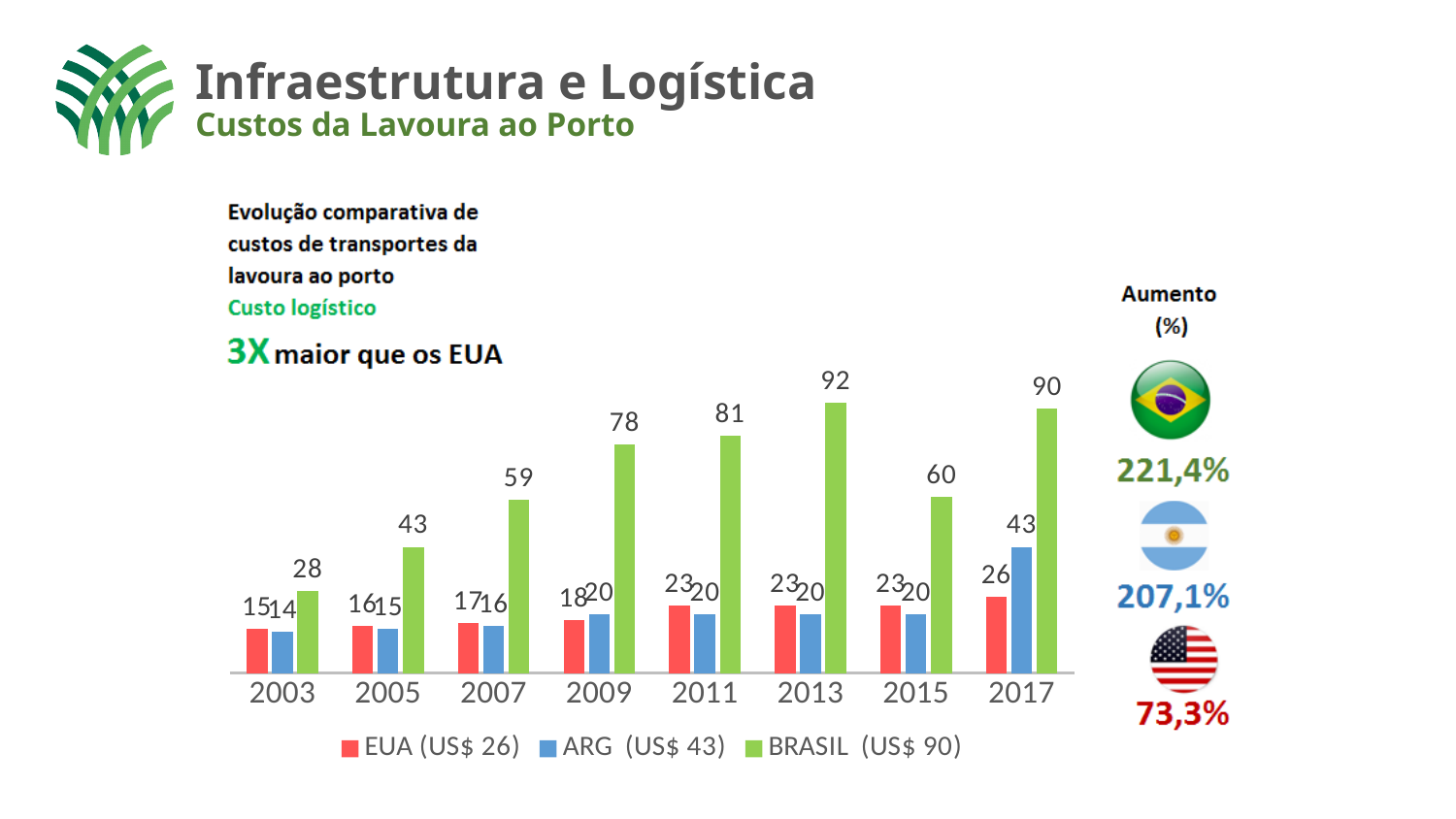
Does the EUA value rise or fall from 2003 to 2017? Rise Which is larger in 2009, the EUA value or the ARG value? ARG How many series does the legend list? 3 What kind of chart is shown on the slide? Bar chart What is the value for BRASIL in 2013? 92 What is the value for EUA in 2003? 15 In which year is the BRASIL value lowest? 2003 What colour are the BRASIL bars? Green What is the difference between the BRASIL and EUA values in 2017? 64 How many years are shown on the x axis? 8 In which year is the BRASIL value highest? 2013 What is the value for ARG in 2017? 43